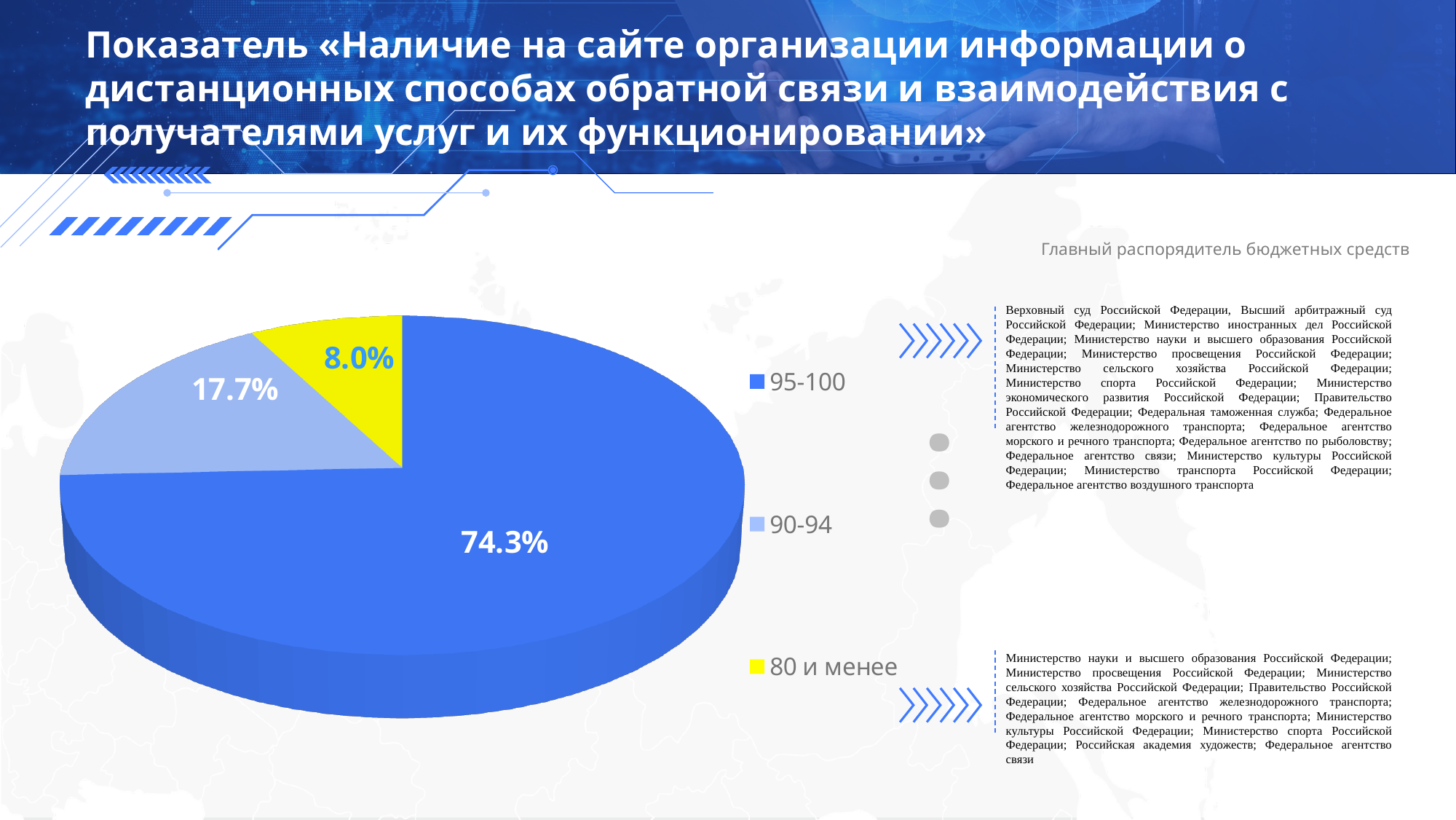
What share of the pie does the "80 и менее" category have? 8.0% Which category has the largest slice of the pie? 95-100 How many categories are shown in the pie chart? 3 What kind of chart is shown on the slide? Pie chart What is the difference in percentage points between the "90-94" slice and the "80 и менее" slice? 9.7 What share of the pie does the "95-100" category have? 74.3% What colour is the "80 и менее" slice in the pie chart? Yellow Which category has the smallest slice of the pie? 80 и менее What is the difference in percentage points between the "95-100" slice and the "90-94" slice? 56.6 What share of the pie does the "90-94" category have? 17.7% Which slice is larger, "90-94" or "80 и менее"? 90-94 How many entries does the legend list? 3